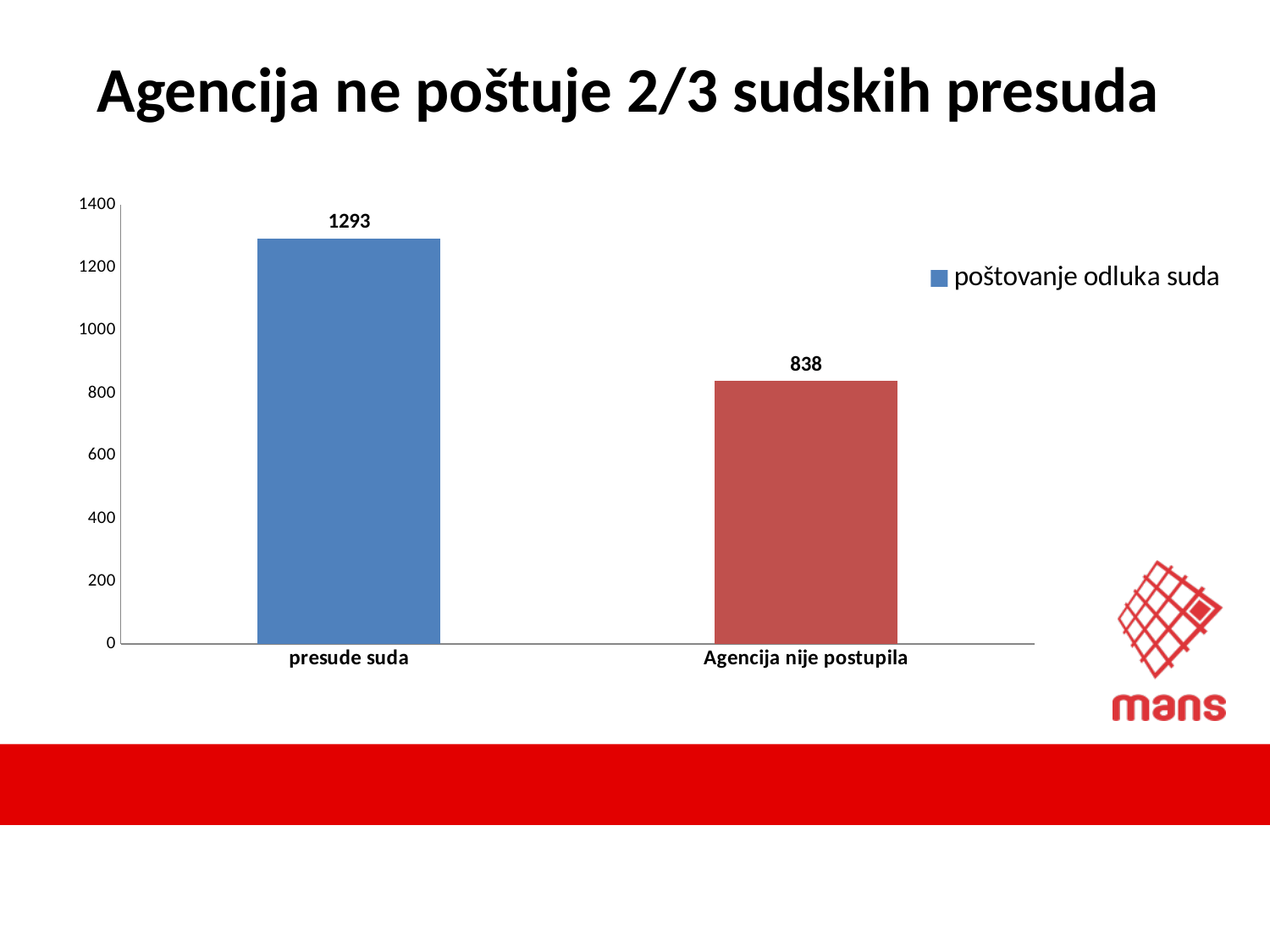
What is the value for "presude suda"? 1293 Which category has the lowest value? Agencija nije postupila Is the value for "Agencija nije postupila" greater or less than 1000? less What is the difference between the values for "presude suda" and "Agencija nije postupila"? 455 How many series does the legend list? 1 What is the value for "Agencija nije postupila"? 838 What is the legend entry shown on the chart? poštovanje odluka suda Which is larger, the value for "presude suda" or for "Agencija nije postupila"? presude suda Is the value for "presude suda" greater or less than 1200? greater What kind of chart is shown on the slide? bar chart Which category has the highest value? presude suda How many categories are shown on the x axis? 2